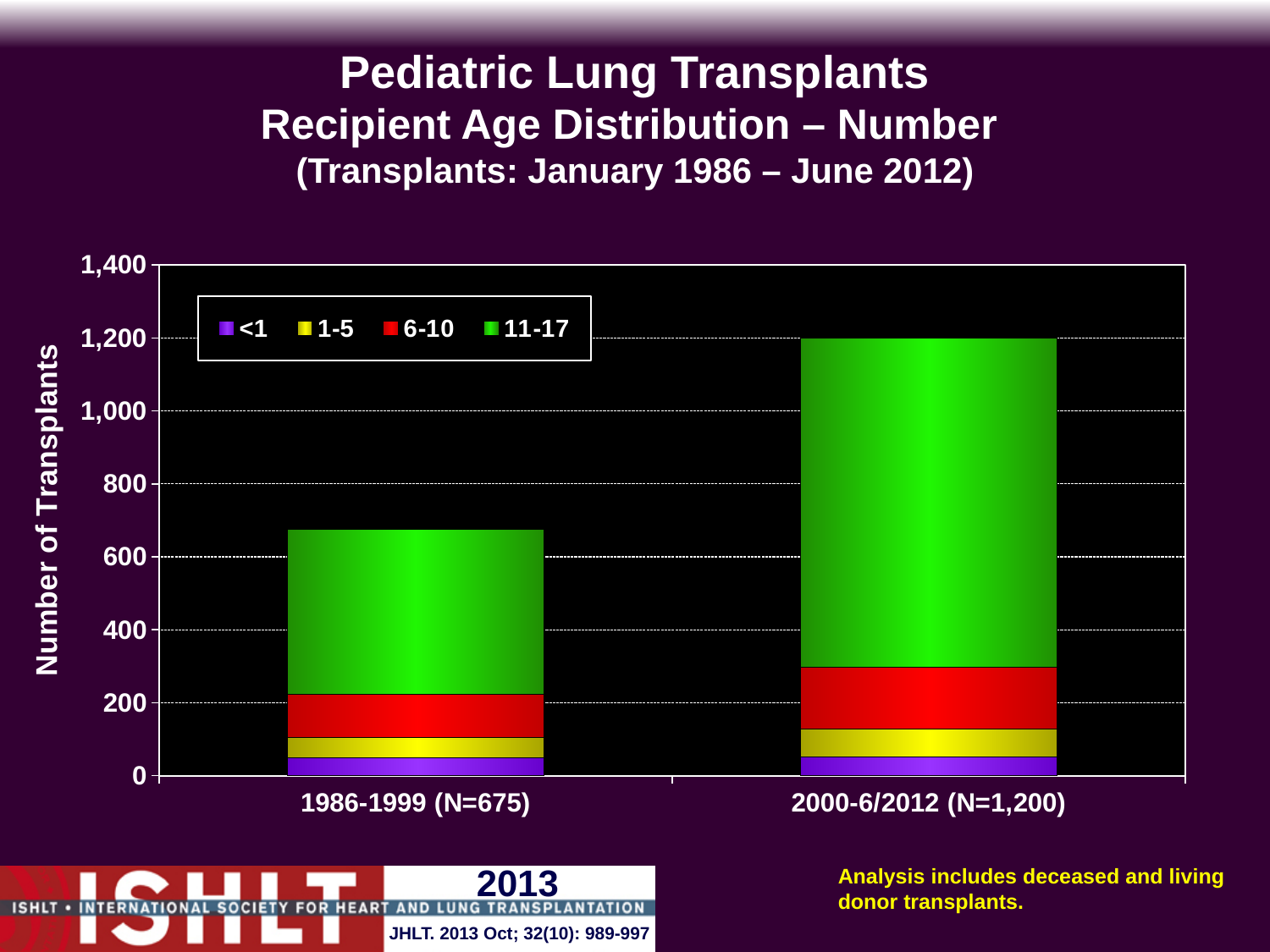
What kind of chart is shown on the slide? Stacked bar chart What is the difference between the total transplants in 2000-6/2012 and in 1986-1999? 525 How many time-period categories are shown on the x axis? 2 Is the total number of transplants for 2000-6/2012 greater or less than 1,000? greater Which age group makes up the largest segment of the 2000-6/2012 bar? 11-17 How many age-group series does the legend list? 4 Do the total number of transplants rise or fall from the 1986-1999 period to the 2000-6/2012 period? rise What is the total number of transplants for the 2000-6/2012 bar? 1,200 Which period has the higher total number of transplants, 1986-1999 or 2000-6/2012? 2000-6/2012 What is the total number of transplants for the 1986-1999 bar? 675 What is the label of the y axis? Number of Transplants Is the total number of transplants for 1986-1999 greater or less than 800? less